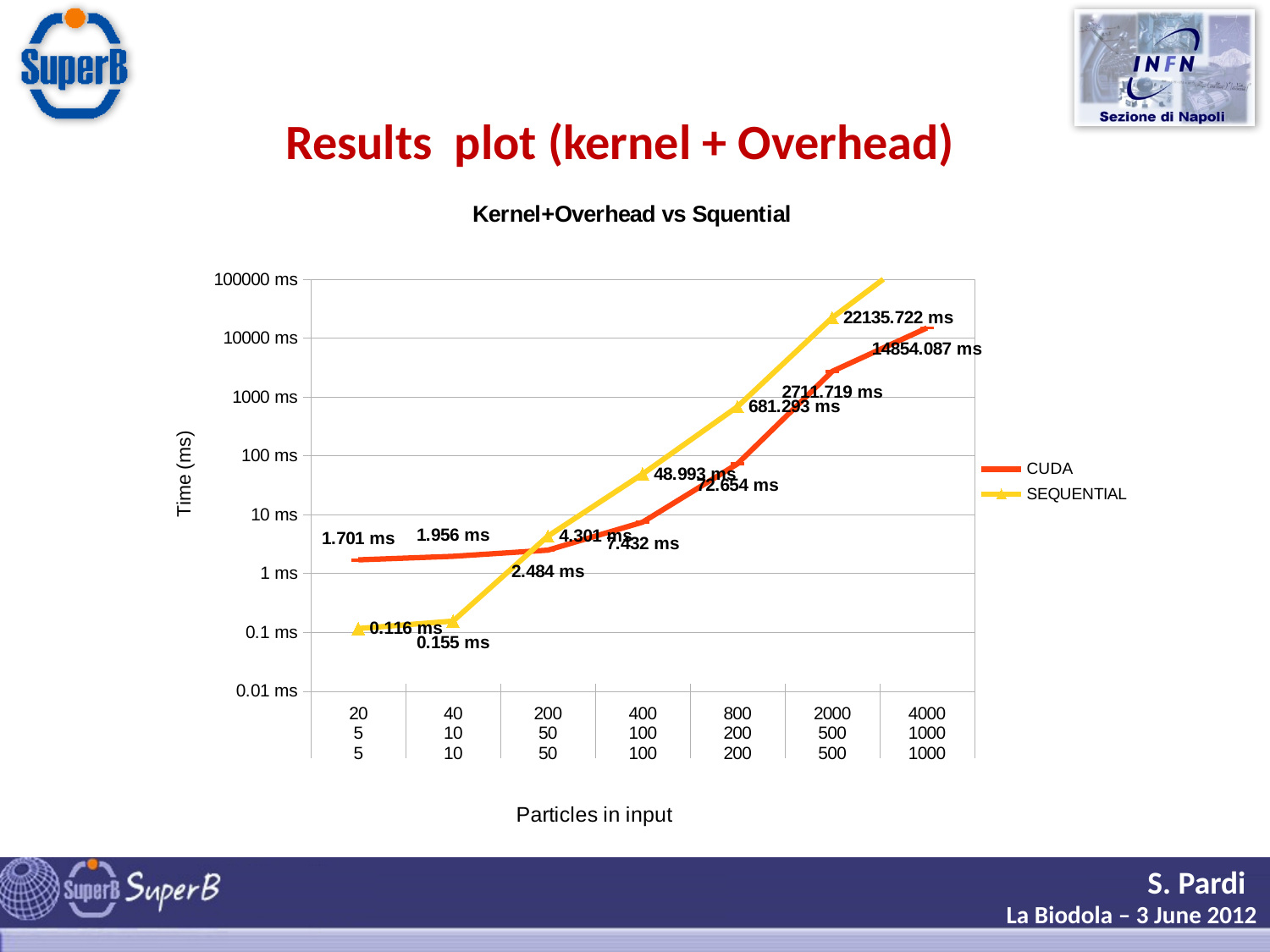
What is the SEQUENTIAL time for the first input size (20 particles)? 0.116 ms What is the SEQUENTIAL time at 2000 particles in input? 22135.722 ms What is the CUDA time for the largest input size (4000 particles)? 14854.087 ms What are the two series named in the legend? CUDA and SEQUENTIAL What is the CUDA time for the first input size (20 particles)? 1.701 ms How many input-size categories are shown on the x axis? 7 At 20 particles in input, which series has the larger time, CUDA or SEQUENTIAL? CUDA Is the SEQUENTIAL value at 4000 particles greater or less than 10000 ms? greater At 2000 particles in input, which series has the larger time, CUDA or SEQUENTIAL? SEQUENTIAL Do the CUDA times rise or fall as the number of particles in input increases? Rise How many series does the legend list? 2 What kind of chart is shown on the slide? Line chart